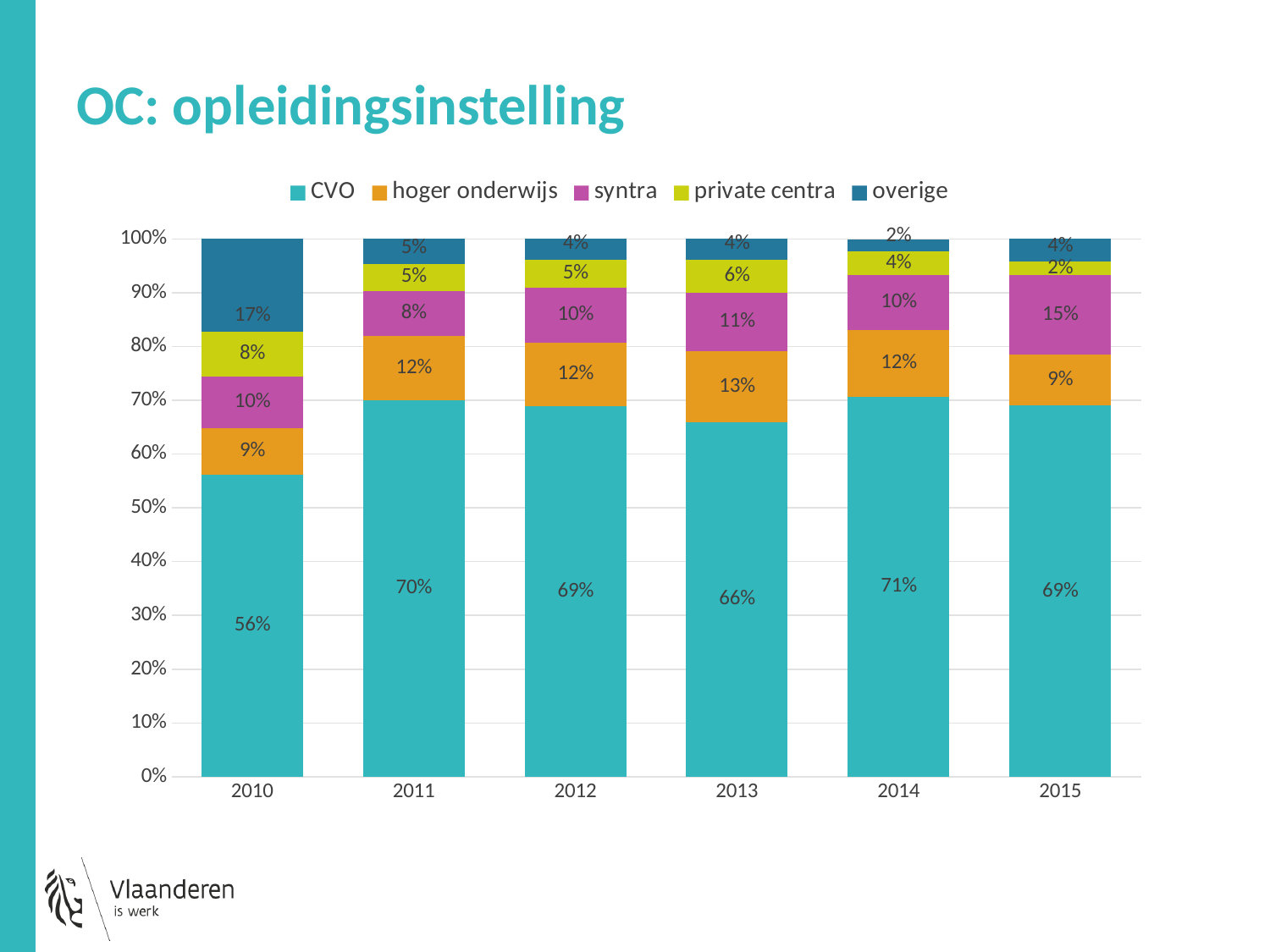
What is the CVO share in 2010? 56% What is the syntra share in 2015? 15% What is the overige share in 2014? 2% What kind of chart is shown on the slide? stacked bar chart In which year is the CVO share highest? 2014 How many years are shown on the x axis? 6 Which is larger, the syntra share in 2015 or the syntra share in 2011? 2015 How many series does the legend list? 5 What is the title of the slide? OC: opleidingsinstelling In which year is the CVO share lowest? 2010 What is the difference between the CVO share in 2014 and in 2010? 15% What is the hoger onderwijs share in 2013? 13%